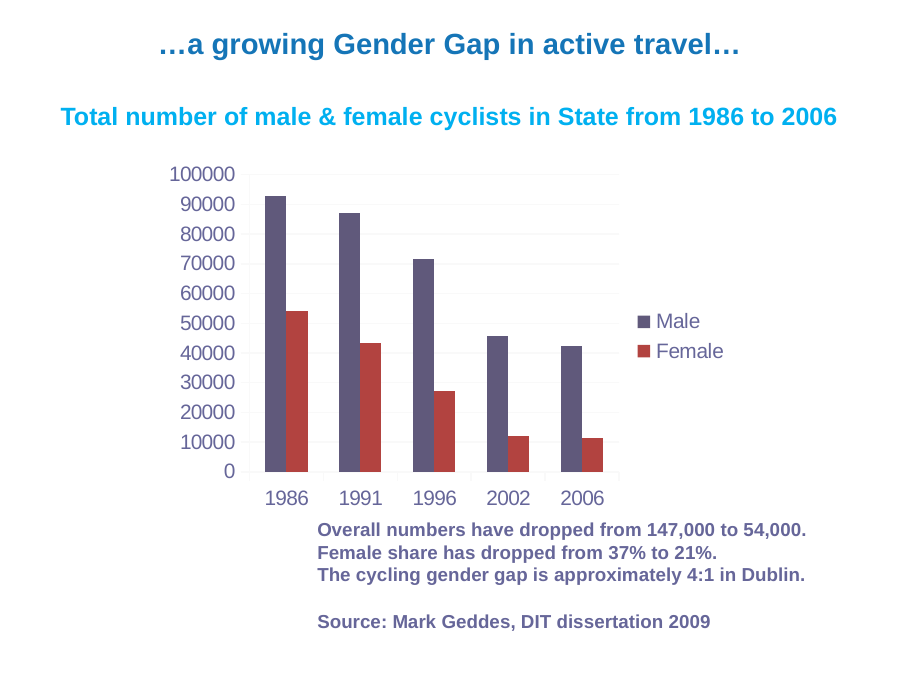
Which is larger in 1991, the Male value or the Female value? Male Is the value for Male in 1996 greater or less than 80000? less Is the value for Female in 1986 greater or less than 50000? greater In which year is the number of female cyclists highest? 1986 Is the value for Male in 1986 greater or less than 90000? greater In which year is the number of male cyclists highest? 1986 How many years are shown on the x axis? 5 How many series does the legend list? 2 Do the Male values rise or fall from 1986 to 2006? fall What kind of chart is shown on the slide? bar chart